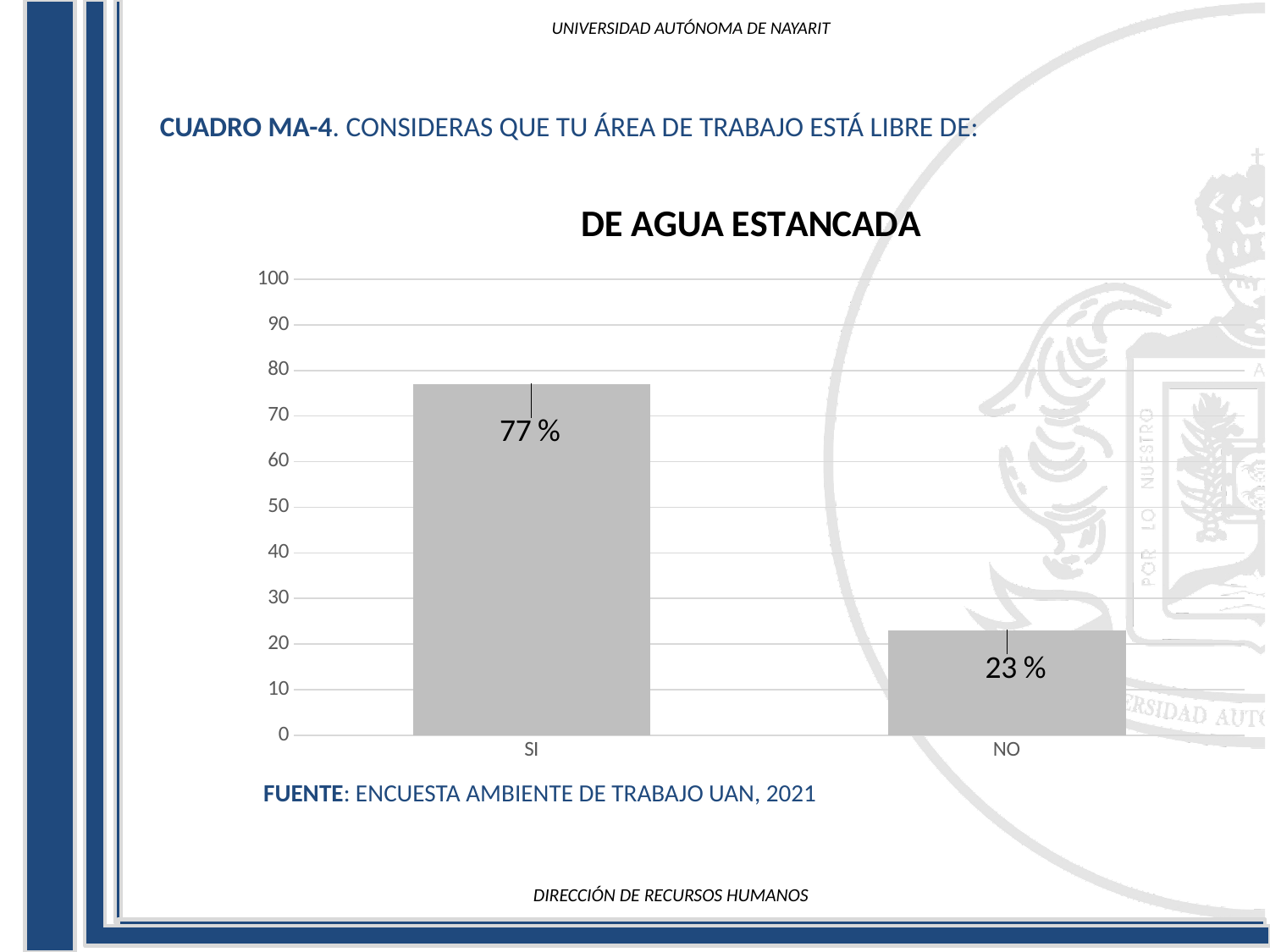
Is the value for NO greater or less than 30? less Is the value for SI greater or less than 50? greater What is the value for SI? 77 % Which is larger, the value for SI or the value for NO? SI Which category has the lowest value? NO What is the value for NO? 23 % Which category has the highest value? SI How many categories are shown on the x axis? 2 What is the title of the chart? DE AGUA ESTANCADA What kind of chart is shown? bar chart What is the maximum value shown on the y axis? 100 What is the difference between the values for SI and NO? 54 %